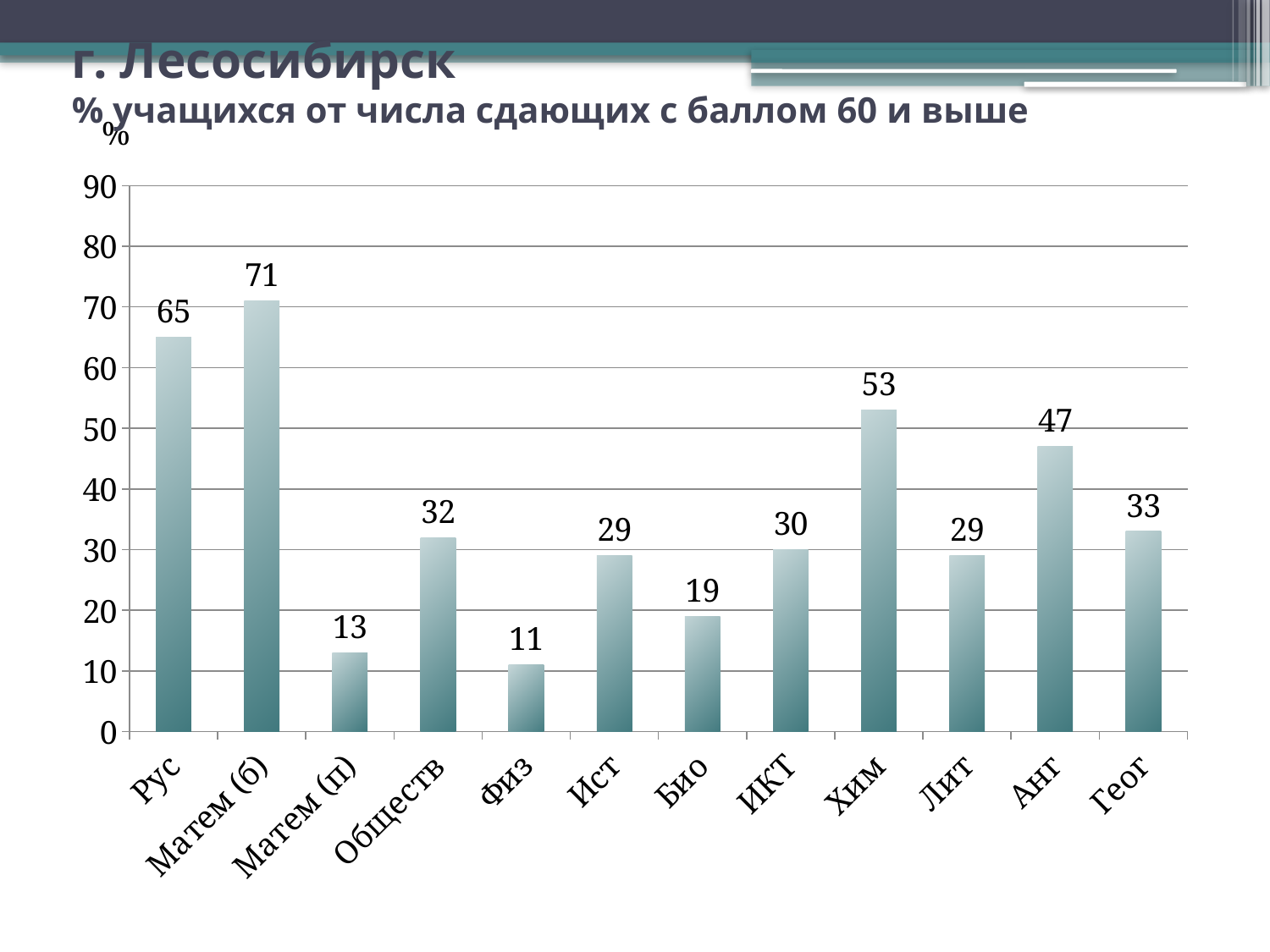
How many categories are shown on the x axis? 12 What kind of chart is shown on the slide? bar chart What is the value for Рус? 65 Is the value for Обществ greater or less than 40? less What is the difference between the values for Матем (б) and Матем (п)? 58 What is the value for Хим? 53 Which category has the lowest value? Физ Which is larger, the value for Анг or the value for Геог? Анг What is the difference between the values for Хим and Анг? 6 What label is shown on the vertical axis? % What is the value for Био? 19 Which category has the highest value? Матем (б)